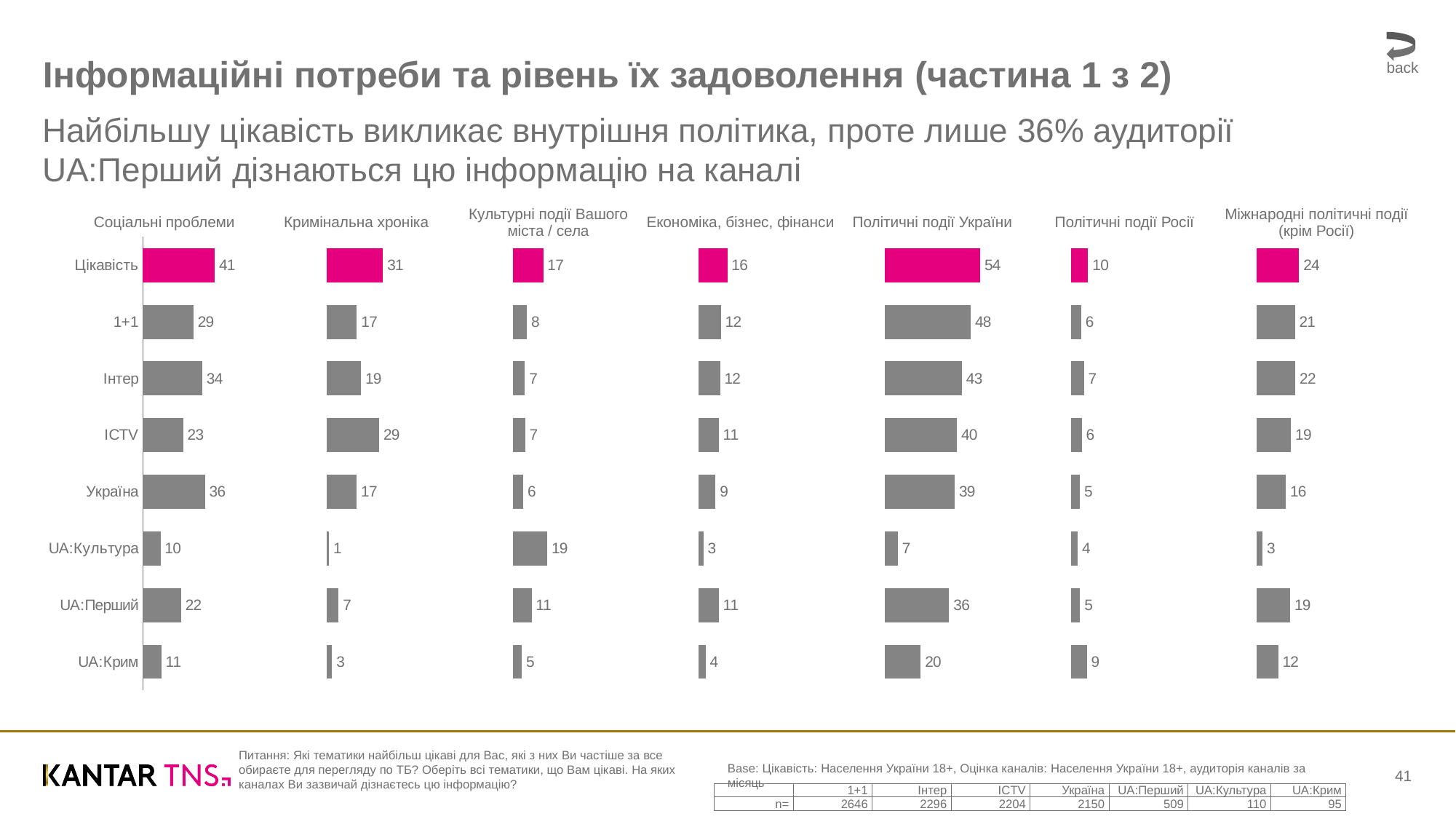
In the 'Соціальні проблеми' chart, which is larger: the value for Україна or the value for Інтер? Україна In the 'Соціальні проблеми' chart, what is the value for UA:Перший? 22 In the 'Міжнародні політичні події (крім Росії)' chart, what is the value for Інтер? 22 In the 'Кримінальна хроніка' chart, which category has the lowest value? UA:Культура In the 'Кримінальна хроніка' chart, what is the value for ICTV? 29 What kind of chart is used on the slide? Bar chart In the 'Політичні події Росії' chart, what is the value for UA:Крим? 9 In the 'Культурні події Вашого міста / села' chart, which category has the highest value? UA:Культура In the 'Політичні події України' chart, what is the value for Цікавість? 54 In the 'Політичні події України' chart, what is the difference between the values for Цікавість and UA:Перший? 18 How many categories (rows) does each chart on the slide show? 8 How many separate topic charts are shown on the slide? 7